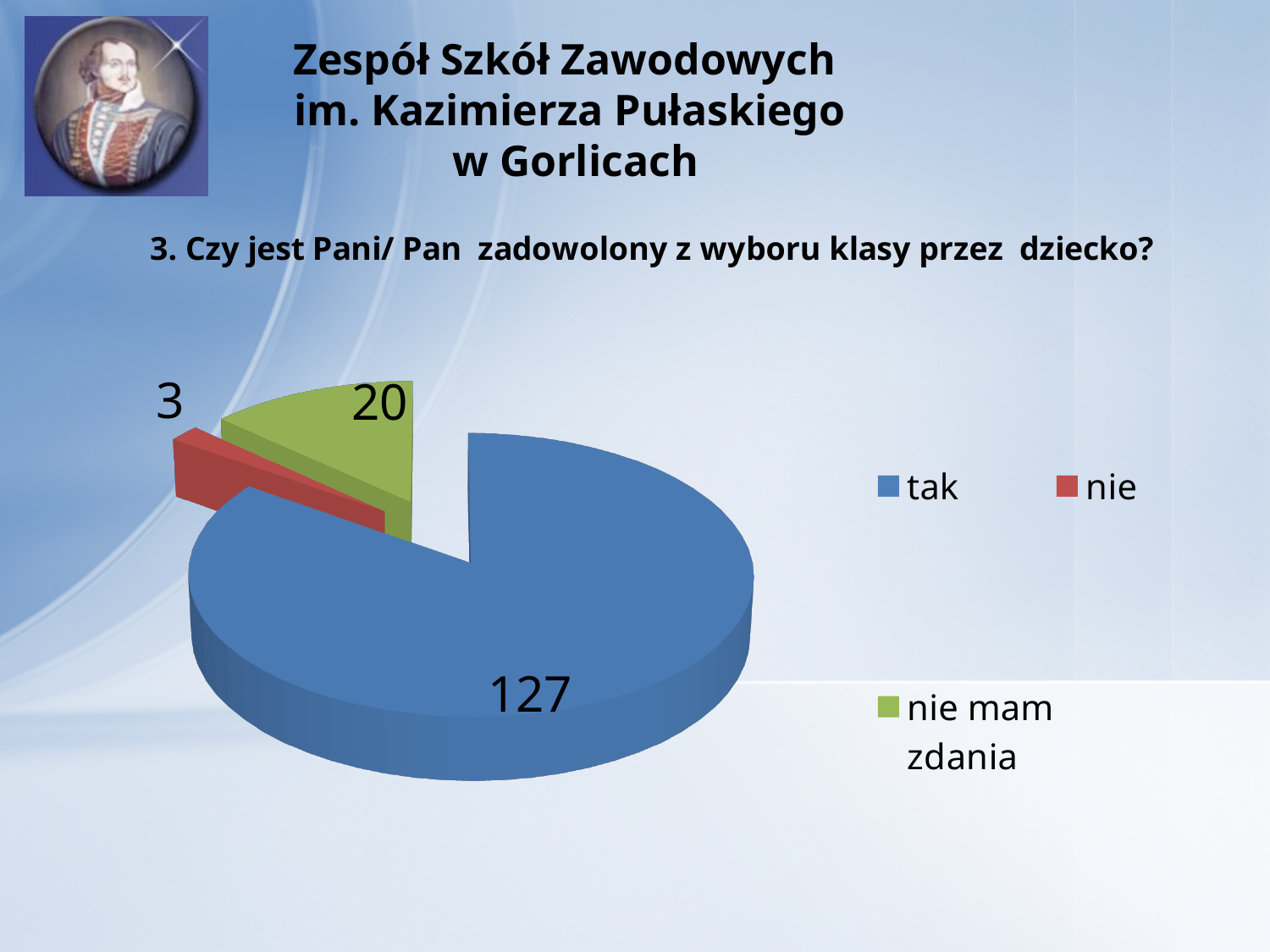
Which category has the largest slice? tak What is the total of all slices in the pie chart? 150 What is the difference between the values for "nie mam zdania" and "nie"? 17 What is the value for "nie"? 3 What is the value for "tak"? 127 What is the difference between the values for "tak" and "nie mam zdania"? 107 Which is larger, the value for "nie" or the value for "nie mam zdania"? nie mam zdania Which category has the smallest slice? nie How many slices does the pie chart have? 3 What colour is the slice for "tak"? blue What kind of chart is shown on the slide? pie chart What is the value for "nie mam zdania"? 20